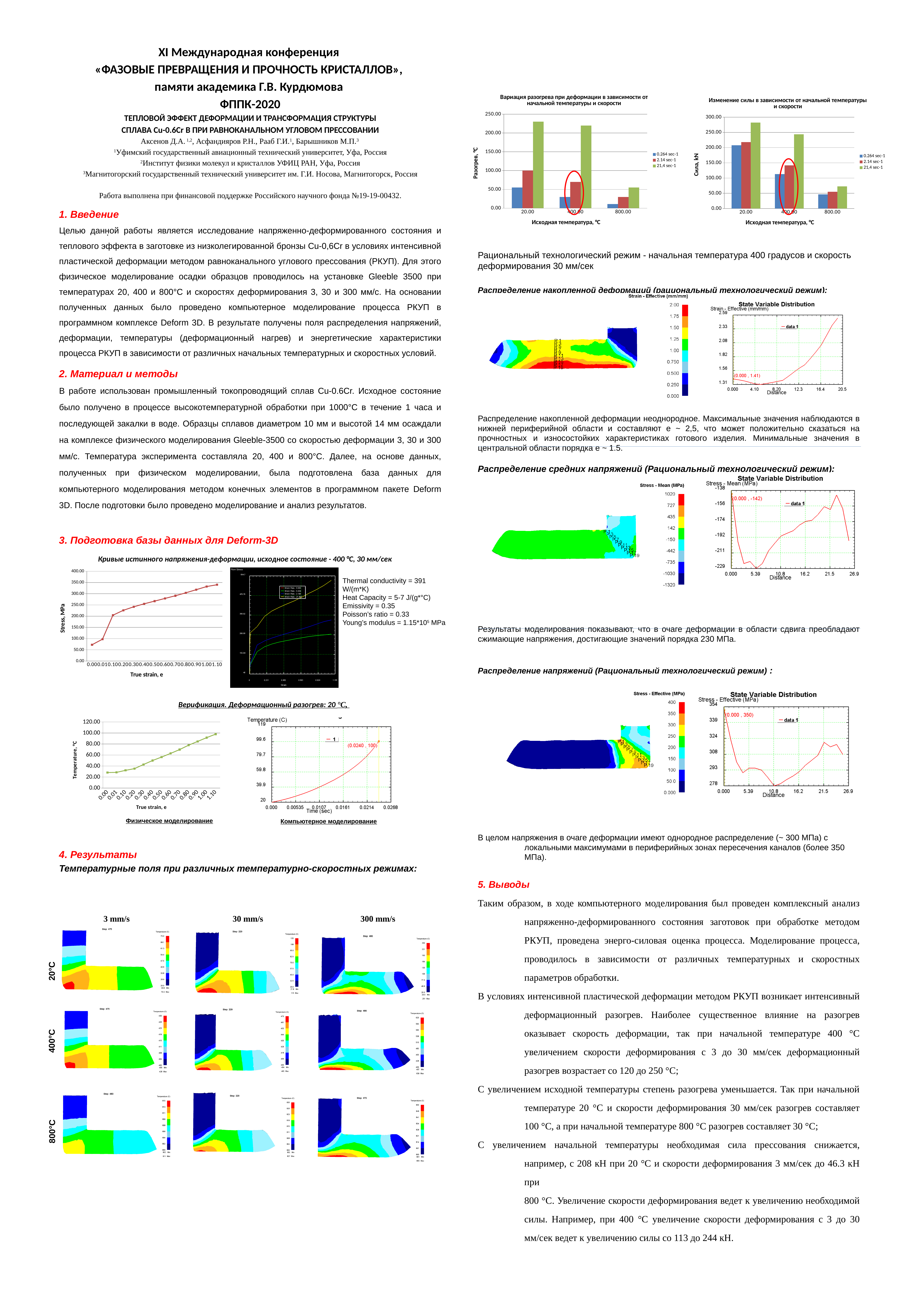
How many initial temperature categories are shown on the x axis of the 'Вариация разогрева при деформации' chart? 3 What is the y-axis label of the 'Изменение силы в зависимости от начальной температуры и скорости' chart? Сила, kN In the 'Изменение силы в зависимости от начальной температуры и скорости' chart, do the values for the 21.4 sec-1 series rise or fall as the initial temperature increases? fall In the 'Изменение силы в зависимости от начальной температуры и скорости' chart, is the value for the 21.4 sec-1 series at 20.00 °C greater or less than 250? greater In the 'Вариация разогрева при деформации' chart, is the value for the 0.264 sec-1 series at 800.00 °C greater or less than 50? less How many series does the legend of the 'Вариация разогрева при деформации' chart list? 3 In the 'Изменение силы в зависимости от начальной температуры и скорости' chart, at 400.00 °C which series has the larger value: 21.4 sec-1 or 2.14 sec-1? 21.4 sec-1 In the 'Кривые истинного напряжения-деформации' chart on the left, does the stress rise or fall as true strain increases? rise What kind of chart is the 'Вариация разогрева при деформации в зависимости от начальной температуры и скорости' chart? bar chart In the 'Вариация разогрева при деформации' chart, at which initial temperature is the 21.4 sec-1 series lowest? 800.00 In the 'Вариация разогрева при деформации' chart, at 400.00 °C which series has the larger value: 2.14 sec-1 or 0.264 sec-1? 2.14 sec-1 In the 'Вариация разогрева при деформации' chart, is the value for the 21.4 sec-1 series at 20.00 °C greater or less than 200? greater